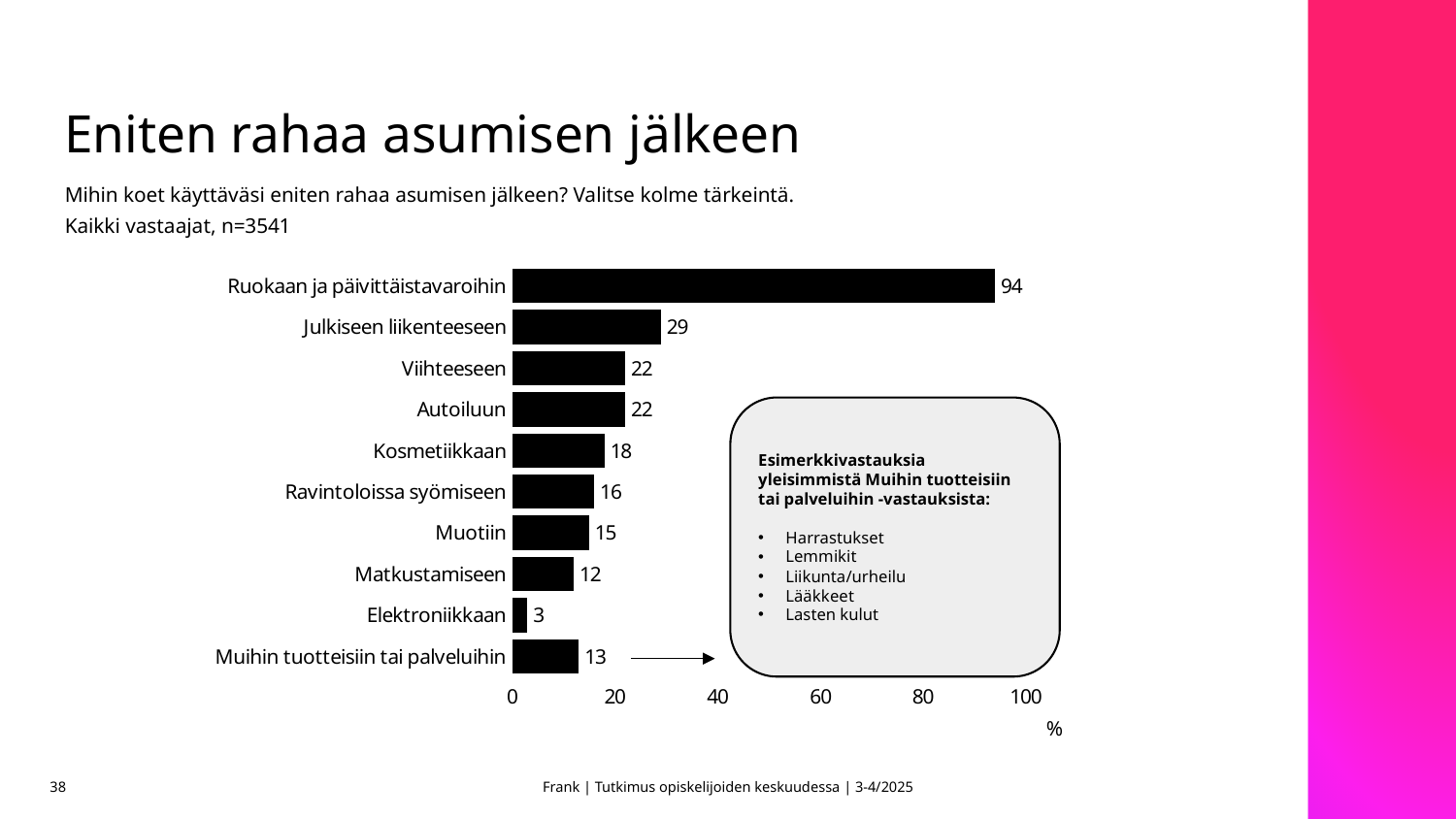
Which is larger, the value for Ravintoloissa syömiseen or the value for Matkustamiseen? Ravintoloissa syömiseen What is the difference between the values for Ruokaan ja päivittäistavaroihin and Julkiseen liikenteeseen? 65 What is the value for Ruokaan ja päivittäistavaroihin? 94 How many categories are shown in the chart? 10 Which category has the highest value? Ruokaan ja päivittäistavaroihin What unit is shown on the x axis of the chart? % What is the value for Muihin tuotteisiin tai palveluihin? 13 What kind of chart is shown on the slide? bar chart Is the value for Julkiseen liikenteeseen greater or less than 40? less What is the value for Kosmetiikkaan? 18 Which category has the lowest value? Elektroniikkaan What is the value for Julkiseen liikenteeseen? 29